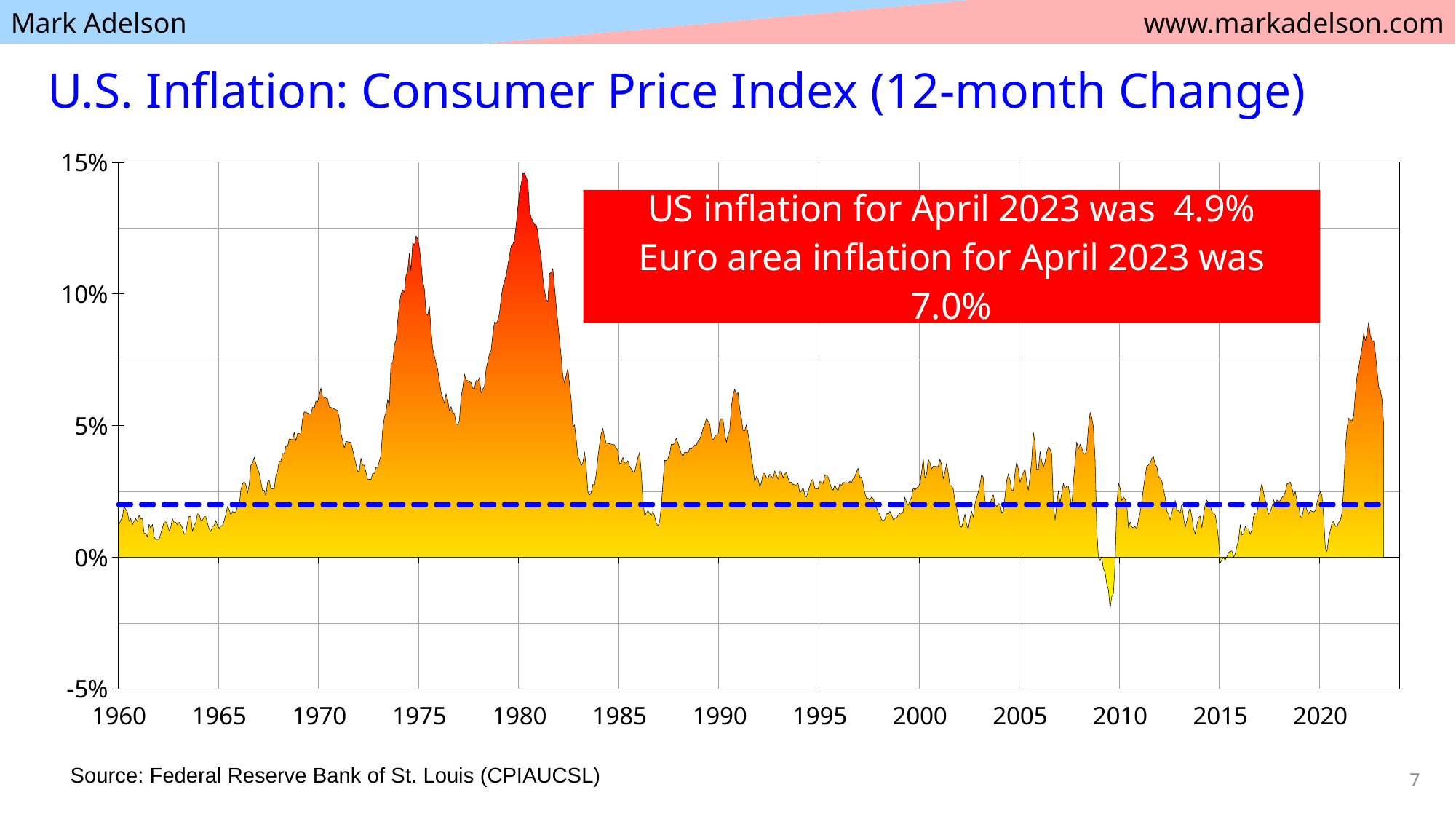
What is the title of the chart? U.S. Inflation: Consumer Price Index (12-month Change) Does inflation rise or fall between 1980 and 1985? Fall Around which year does the chart reach its highest inflation value? 1980 Is the inflation value around 2009 greater or less than 0%? less Is the peak inflation value around 2022 greater or less than 5%? greater Is the peak inflation value around 1980 greater or less than 10%? greater What kind of chart is shown on the slide? Area chart Around which year does the chart reach its lowest inflation value? 2009 By how many percentage points did Euro area inflation exceed US inflation in April 2023? 2.1 percentage points According to the text box on the chart, what was US inflation for April 2023? 4.9% Which was higher in April 2023, US inflation or Euro area inflation? Euro area inflation According to the text box on the chart, what was Euro area inflation for April 2023? 7.0%